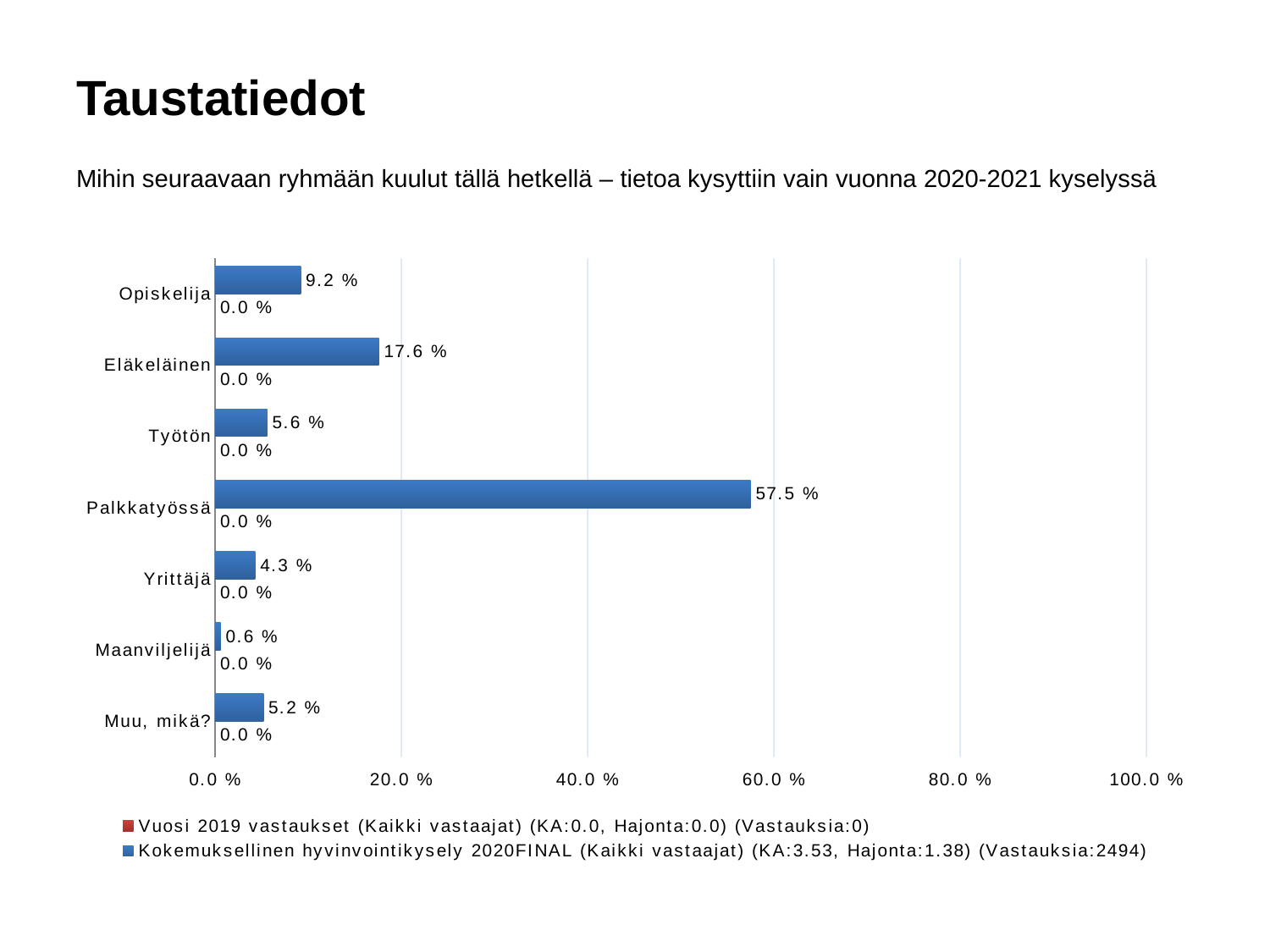
Which category has the highest value in the 2020 survey series? Palkkatyössä What is the value for Maanviljelijä in the 2020 survey series? 0.6 % Which is larger in the 2020 survey series, Työtön or Yrittäjä? Työtön What is the value for Eläkeläinen in the 2020 survey series? 17.6 % How many categories are shown on the chart? 7 What is the difference between the 2020 survey values for Eläkeläinen and Opiskelija? 8.4 % What is the value for Opiskelija in the Vuosi 2019 series? 0.0 % What is the value for Palkkatyössä in the 2020 survey series? 57.5 % What kind of chart is shown on the slide? Bar chart Is the 2020 survey value for Palkkatyössä greater or less than 40.0 %? greater Which category has the lowest value in the 2020 survey series? Maanviljelijä How many series does the legend list? 2